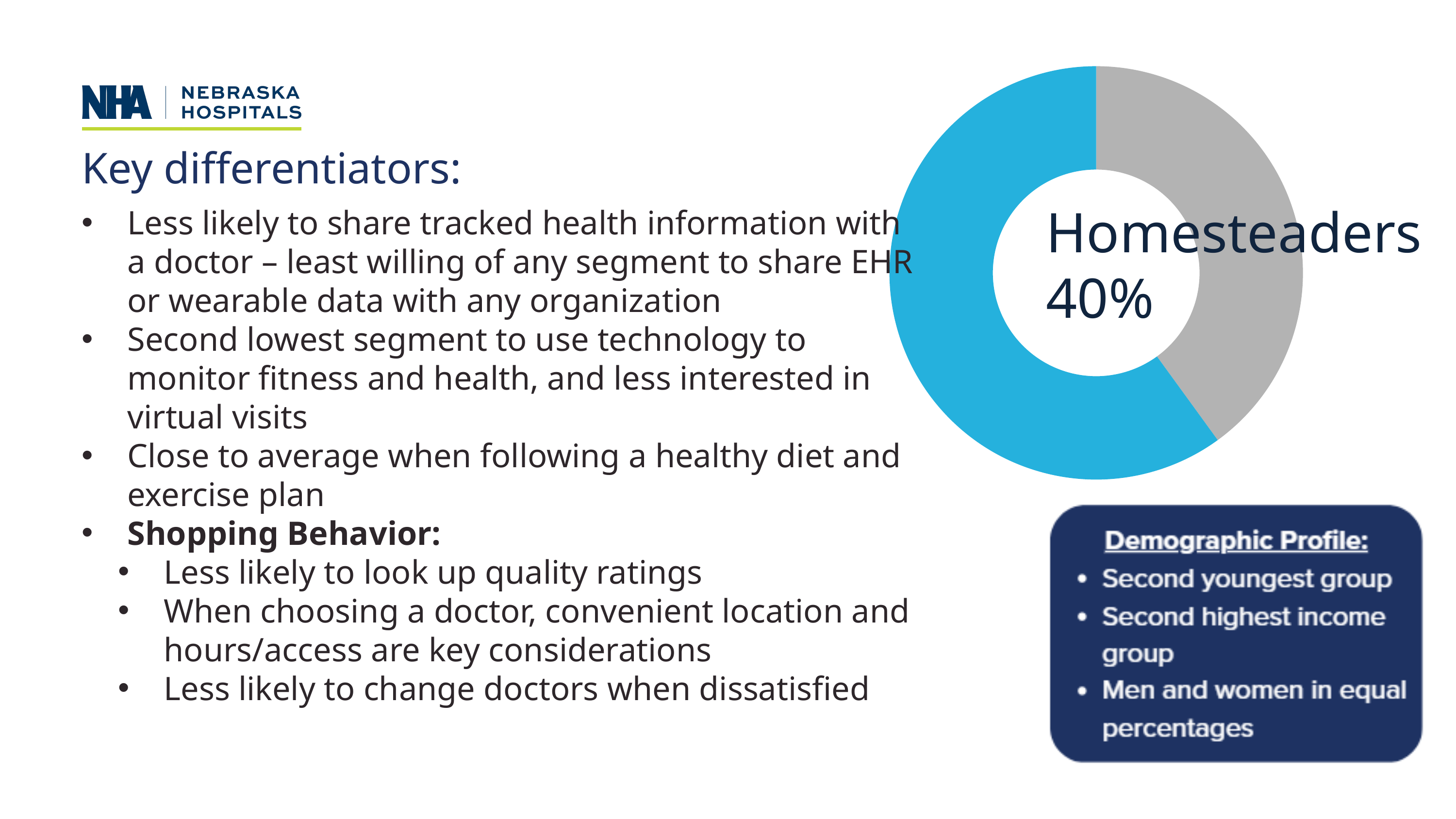
Which slice of the donut chart is the smallest? The gray slice What kind of chart is shown on the right side of the slide? Donut (pie) chart What segment name is printed in the center of the donut chart? Homesteaders How many slices does the donut chart have? 2 Which slice of the donut chart is larger, the blue one or the gray one? Blue What percentage is printed in the center of the donut chart? 40% What two colours are used for the slices of the donut chart? Blue and gray Is the blue slice of the donut chart greater or less than half of the whole? greater